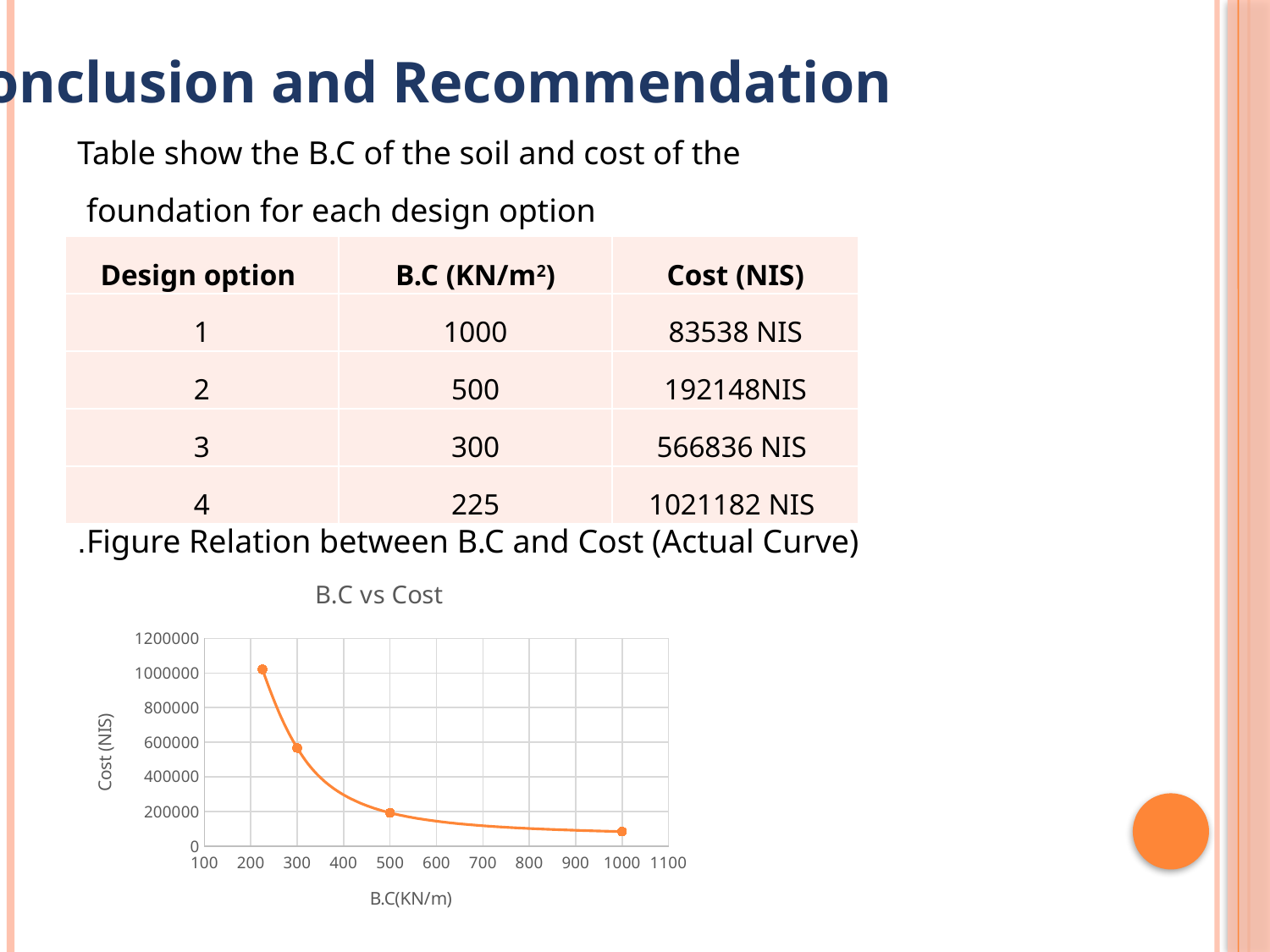
How many data points are plotted on the "B.C vs Cost" chart? 4 On the "B.C vs Cost" chart, at which B.C value is the cost highest? 225 On the "B.C vs Cost" chart, is the cost at B.C 1000 greater or less than 200000? less On the "B.C vs Cost" chart, is the cost at B.C 225 greater or less than 800000? greater What is the label of the y axis on the "B.C vs Cost" chart? Cost (NIS) On the "B.C vs Cost" chart, which has the larger cost: B.C 300 or B.C 500? B.C 300 On the "B.C vs Cost" chart, is the cost at B.C 500 greater or less than 400000? less On the "B.C vs Cost" chart, does the cost rise or fall as B.C increases along the x axis? fall What type of chart is the "B.C vs Cost" chart? line chart What is the title of the chart on the slide? B.C vs Cost On the "B.C vs Cost" chart, at which B.C value is the cost lowest? 1000